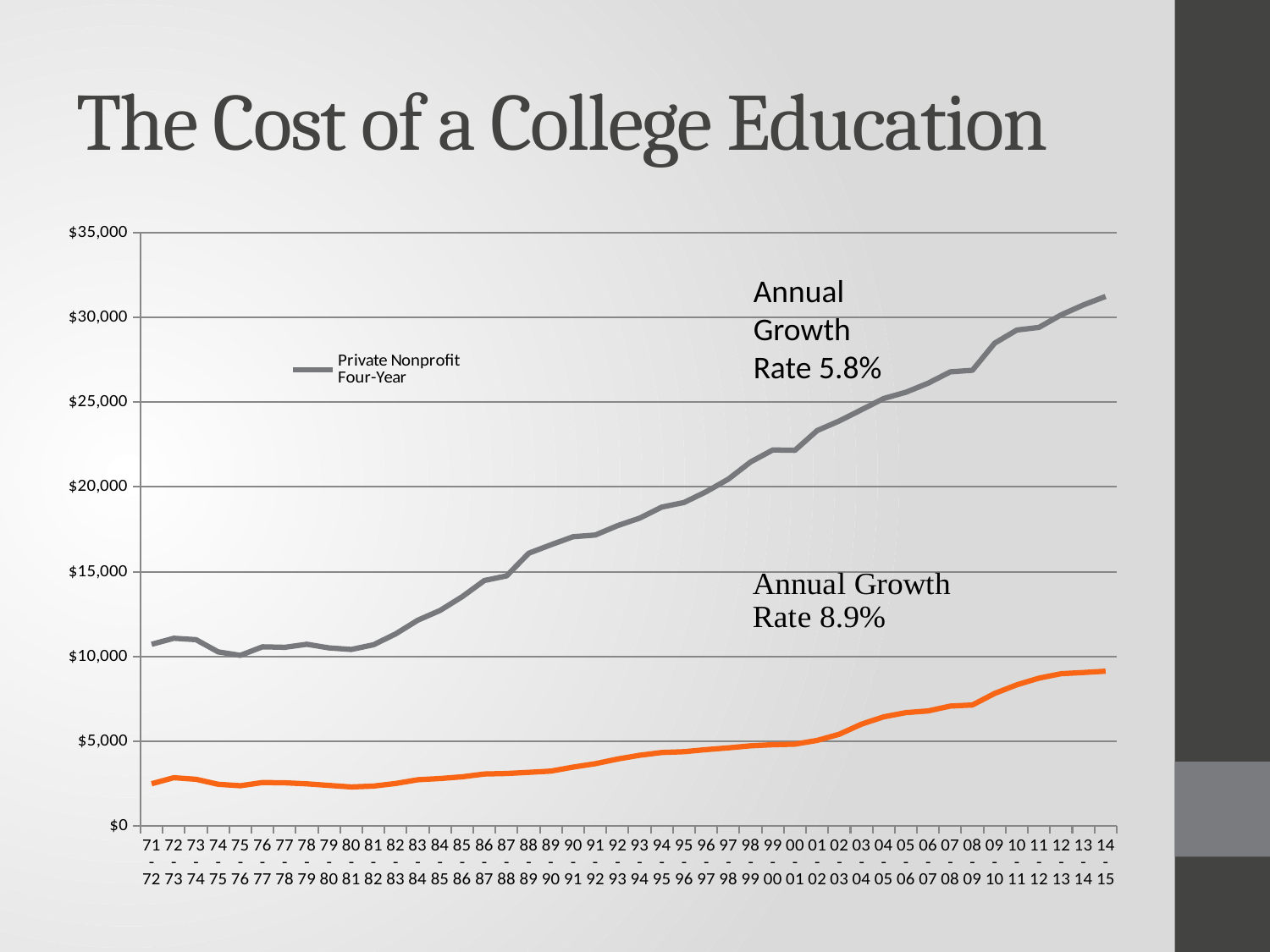
Is the value of the Private Nonprofit Four-Year line for 14-15 greater or less than $30,000? greater Is the value of the Private Nonprofit Four-Year line for 71-72 greater or less than $10,000? greater Which line is higher in 14-15, the gray Private Nonprofit Four-Year line or the orange line? Private Nonprofit Four-Year Is the value of the orange line for 71-72 greater or less than $5,000? less How many series does the legend list? 1 Do the values of the Private Nonprofit Four-Year line generally rise or fall from 71-72 to 14-15? rise What kind of chart is shown on the slide? Line chart How many academic years are plotted along the x axis? 44 What series name does the chart legend list? Private Nonprofit Four-Year What is the title of the slide containing the chart? The Cost of a College Education